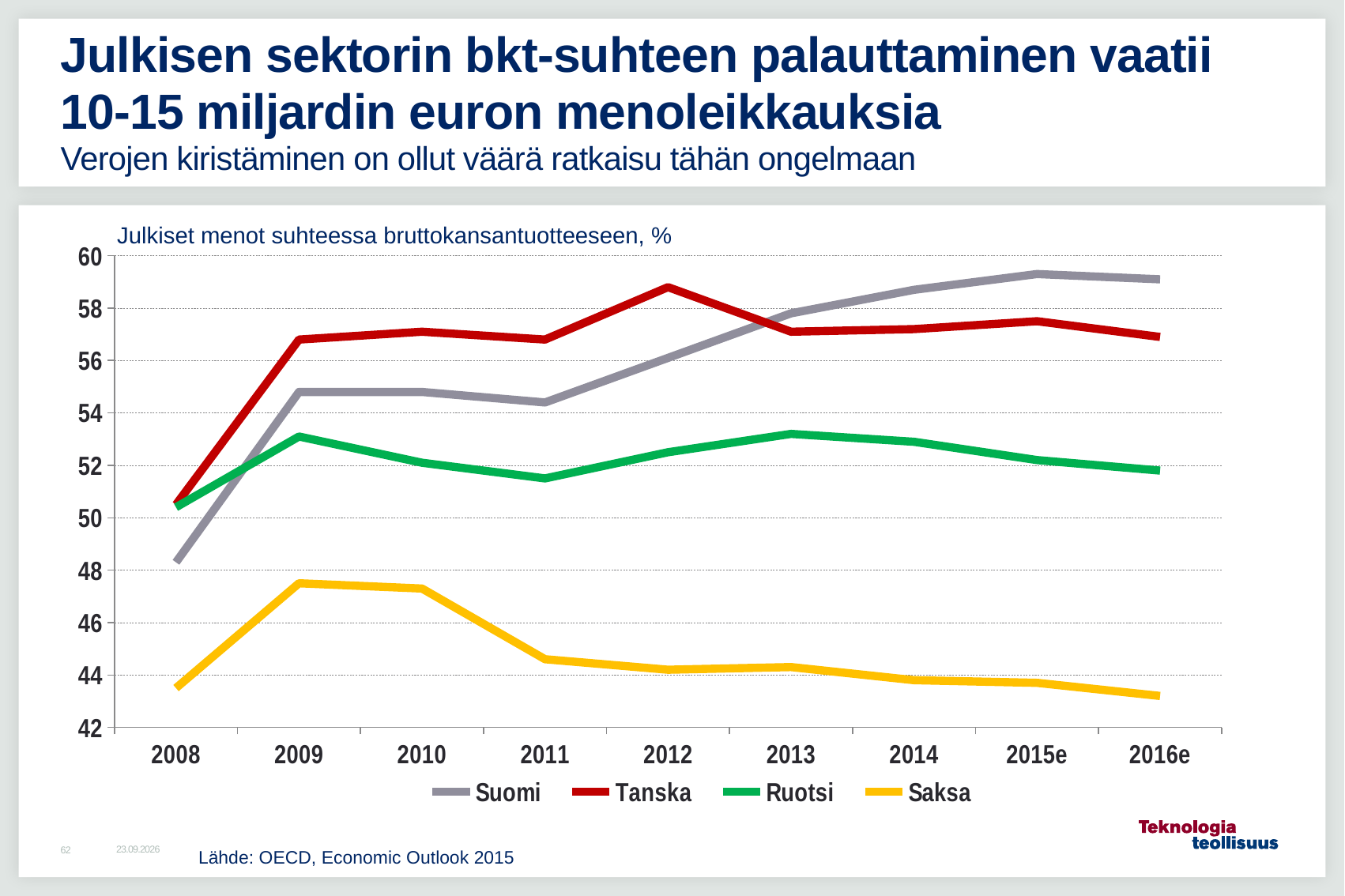
How many years are shown on the x axis? 9 Does the Saksa line rise or fall from 2009 to 2016e? fall Is the value for Tanska in 2012 greater or less than 58? greater Which series has the lowest value in 2016e? Saksa What is the title of the chart? Julkiset menot suhteessa bruttokansantuotteeseen, % What kind of chart is shown on the slide? line chart In 2015e, which is larger: Suomi or Tanska? Suomi How many series does the legend list? 4 Is the value for Saksa in 2008 greater or less than 44? less Which series has the highest value in 2009? Tanska Is the value for Suomi in 2008 greater or less than 50? less